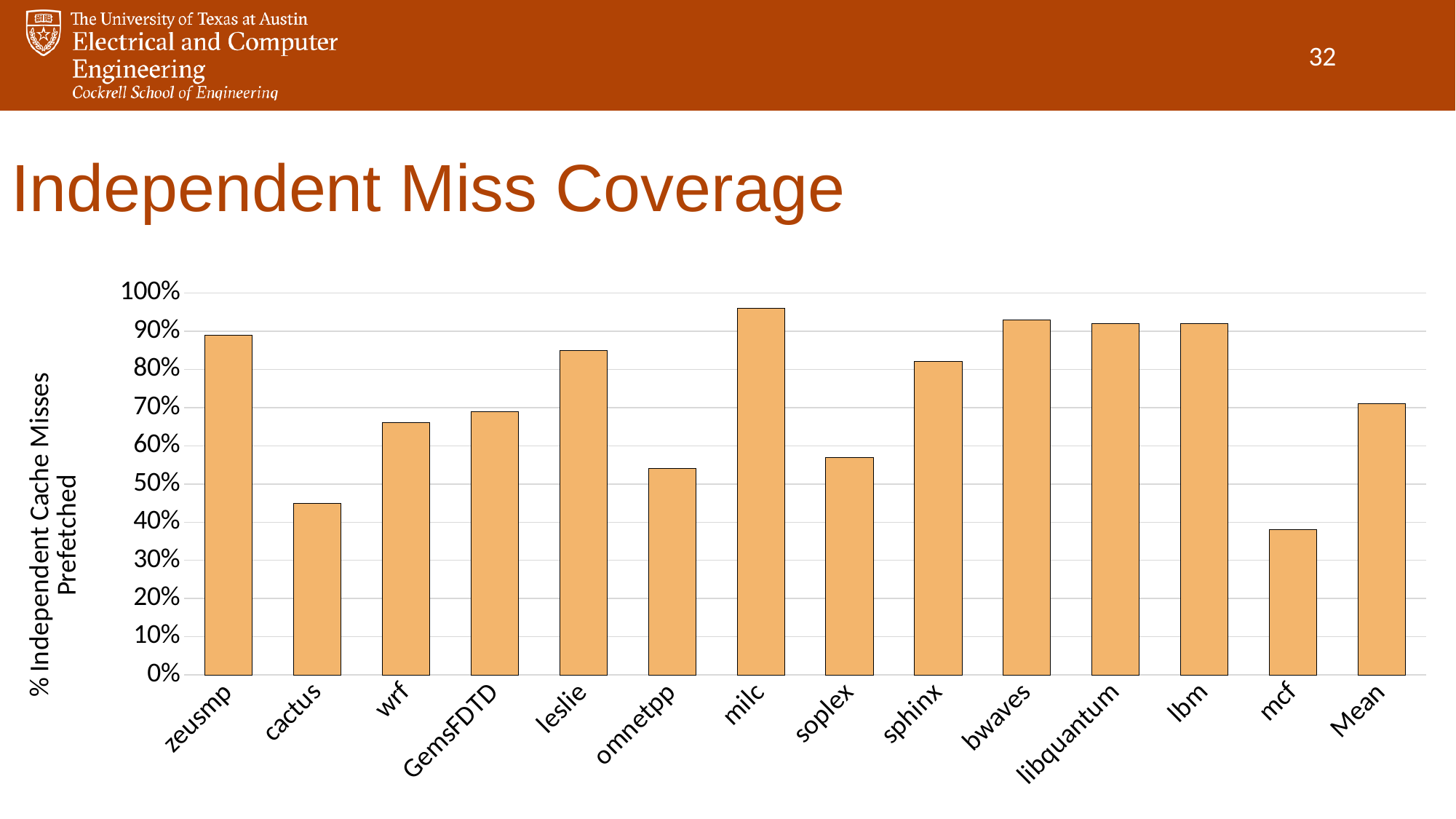
Is the value for Mean greater or less than 60%? greater Which is larger, the value for zeusmp or the value for cactus? zeusmp Is the value for zeusmp greater or less than 80%? greater What is the label of the y axis? % Independent Cache Misses Prefetched Is the value for soplex greater or less than 60%? less Which is larger, the value for bwaves or the value for sphinx? bwaves Which category has the highest value? milc What kind of chart is shown on the slide? bar chart How many categories are plotted along the x axis? 14 Which category has the lowest value? mcf